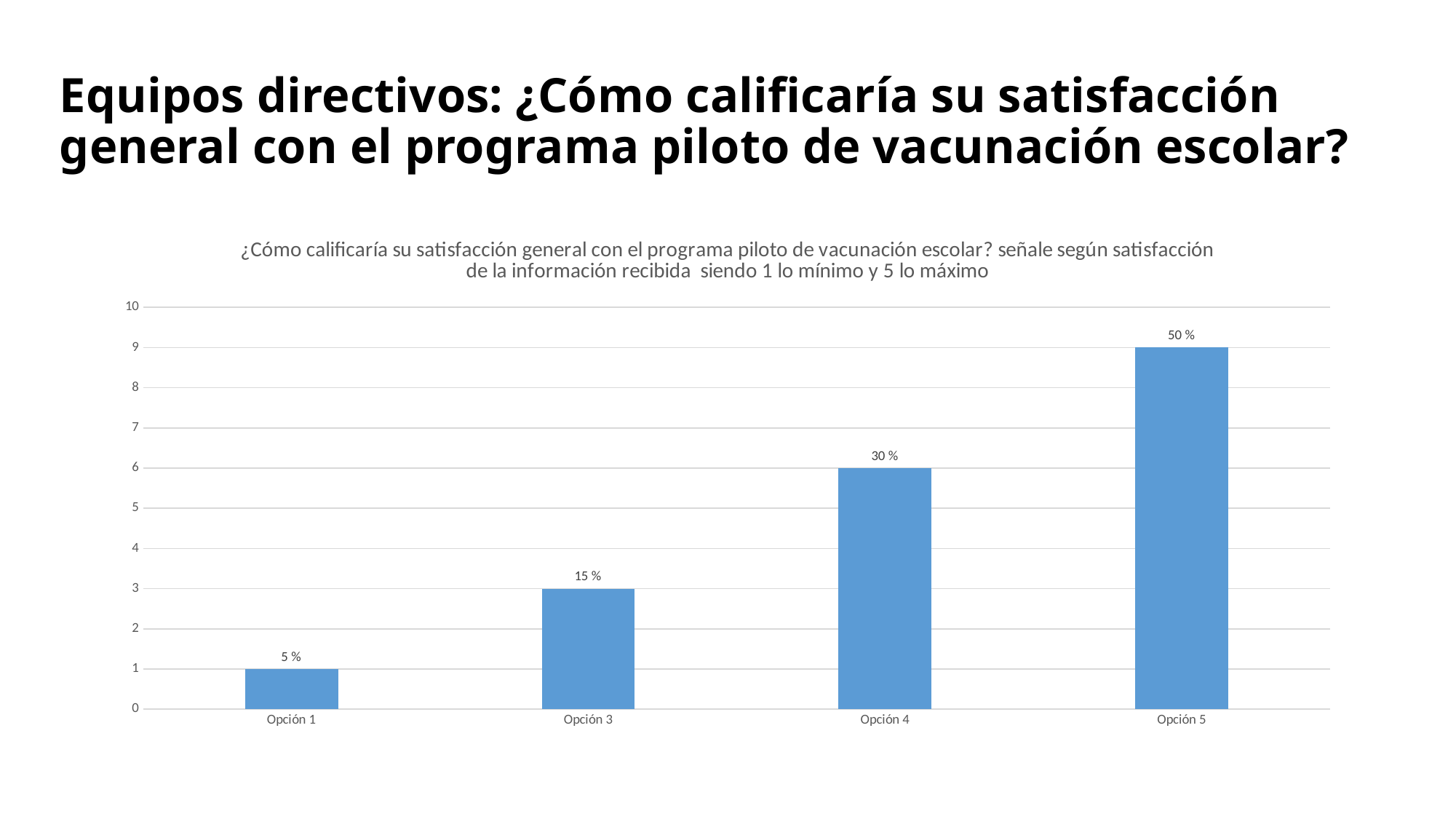
Is the bar for Opción 4 greater or less than 5 on the vertical axis? greater What is the difference between the data labels for Opción 5 and Opción 1? 45 % What is the data label shown for Opción 4? 30 % What is the data label shown for Opción 1? 5 % Which category has the highest bar? Opción 5 What is the data label shown for Opción 5? 50 % Do the bar values rise or fall from Opción 1 to Opción 5? Rise Which is larger, the value for Opción 4 or the value for Opción 3? Opción 4 How many categories are shown on the x axis? 4 What is the data label shown for Opción 3? 15 % What kind of chart is shown on the slide? Bar chart Which category has the lowest bar? Opción 1